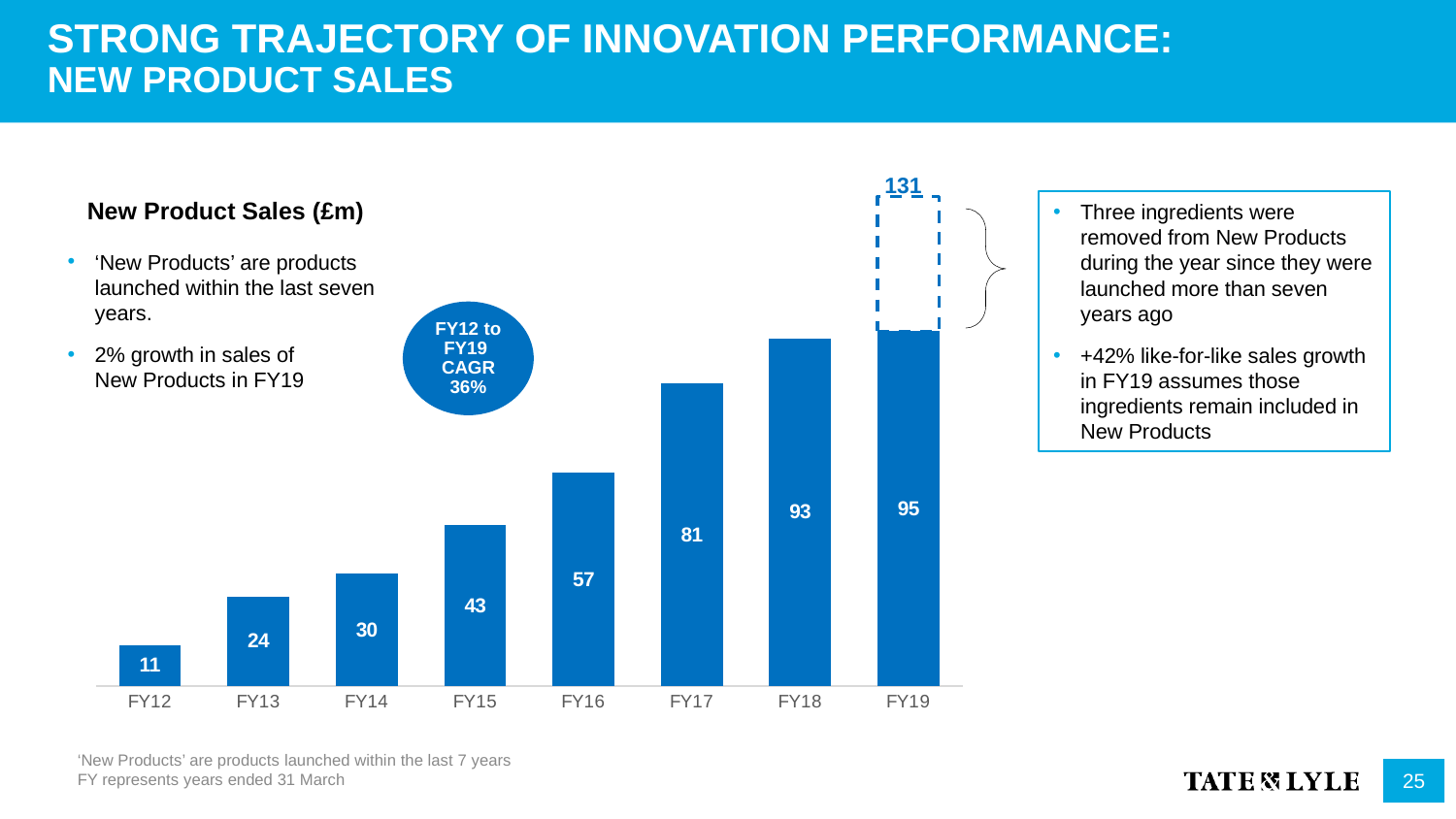
How many fiscal years are shown on the x axis of the chart? 8 What is the value of New Product Sales for FY16? 57 What is the difference between New Product Sales in FY19 and FY18? 2 What value is shown by the dashed outline above the FY19 bar? 131 Which fiscal year has the lowest New Product Sales? FY12 What kind of chart is used to show New Product Sales? Bar chart What is the difference between New Product Sales in FY17 and FY16? 24 Which is larger, New Product Sales in FY15 or FY14? FY15 What is the value of New Product Sales for FY18? 93 What is the value of New Product Sales for FY12? 11 Do New Product Sales rise or fall from FY12 to FY19? Rise Which fiscal year has the highest solid-bar value for New Product Sales? FY19